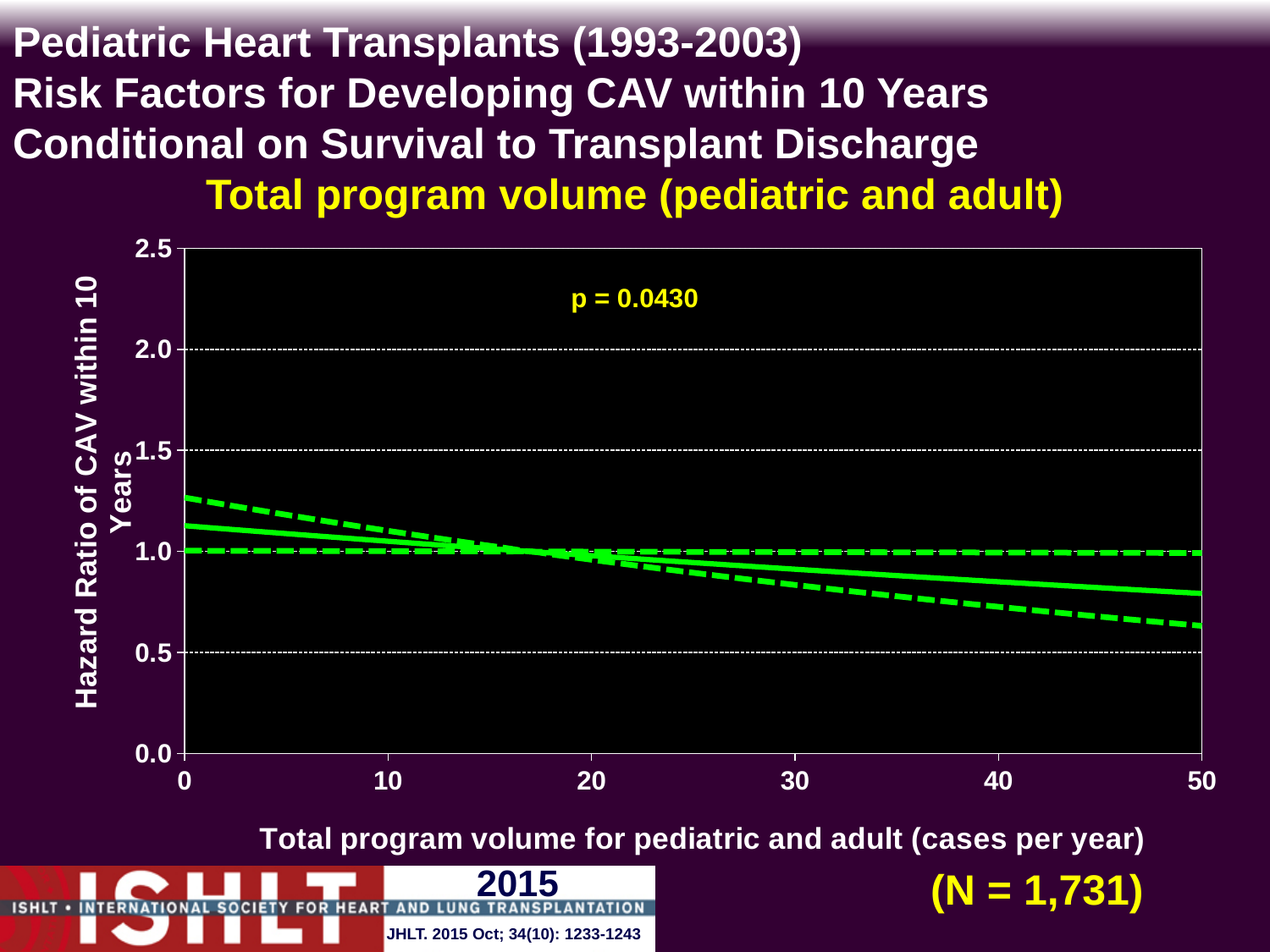
What kind of chart is shown on the slide? line chart What is the sample size (N) shown on the slide? N = 1,731 Is the lower dashed line at a total program volume of 50 cases per year greater or less than 0.5? greater Does the solid hazard ratio line rise or fall as total program volume increases along the x axis? fall What is the maximum value shown on the y axis? 2.5 How many labelled tick marks are there on the x axis? 6 What is the maximum value shown on the x axis? 50 Is the hazard ratio shown by the solid line at a total program volume of 50 cases per year greater or less than 1.0? less Is the hazard ratio shown by the solid line at a total program volume of 0 cases per year greater or less than 1.0? greater What p-value is printed on the chart? p = 0.0430 What is the label of the x axis? Total program volume for pediatric and adult (cases per year)